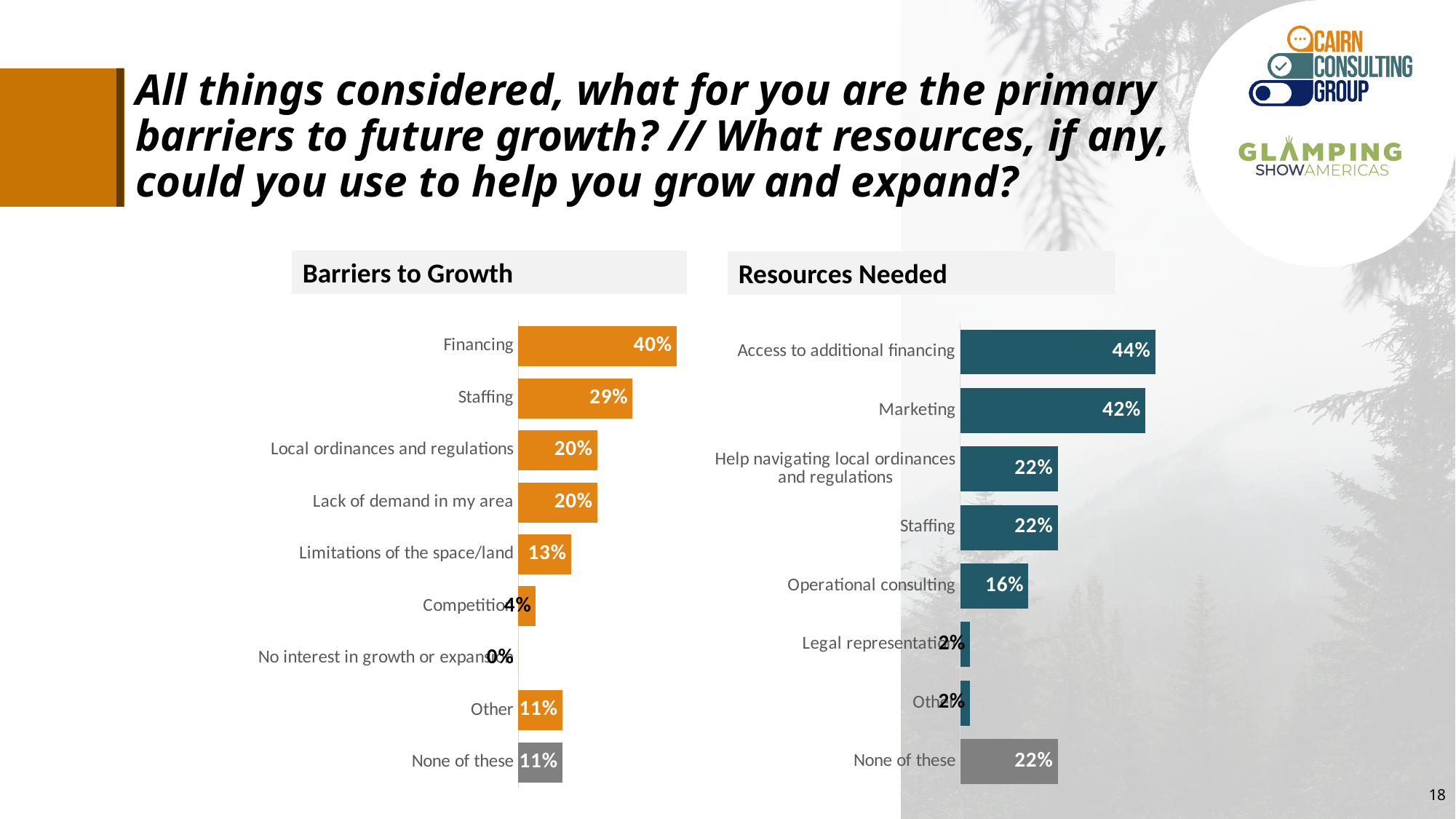
In the Barriers to Growth chart, what is the value for Staffing? 29% In the Barriers to Growth chart, what is the difference between Financing and Staffing? 11% In the Barriers to Growth chart, what is the value for Financing? 40% In the Resources Needed chart, what is the value for Operational consulting? 16% In the Resources Needed chart, what is the difference between Access to additional financing and Help navigating local ordinances and regulations? 22% In the Resources Needed chart, what is the value for Marketing? 42% In the Barriers to Growth chart, which category has the lowest value? No interest in growth or expansion In the Resources Needed chart, which category has the highest value? Access to additional financing In the Barriers to Growth chart, which category has the highest value? Financing What type of chart is the Resources Needed chart? Bar chart In the Barriers to Growth chart, how many categories are shown? 9 In the Resources Needed chart, which is larger: Staffing or Operational consulting? Staffing